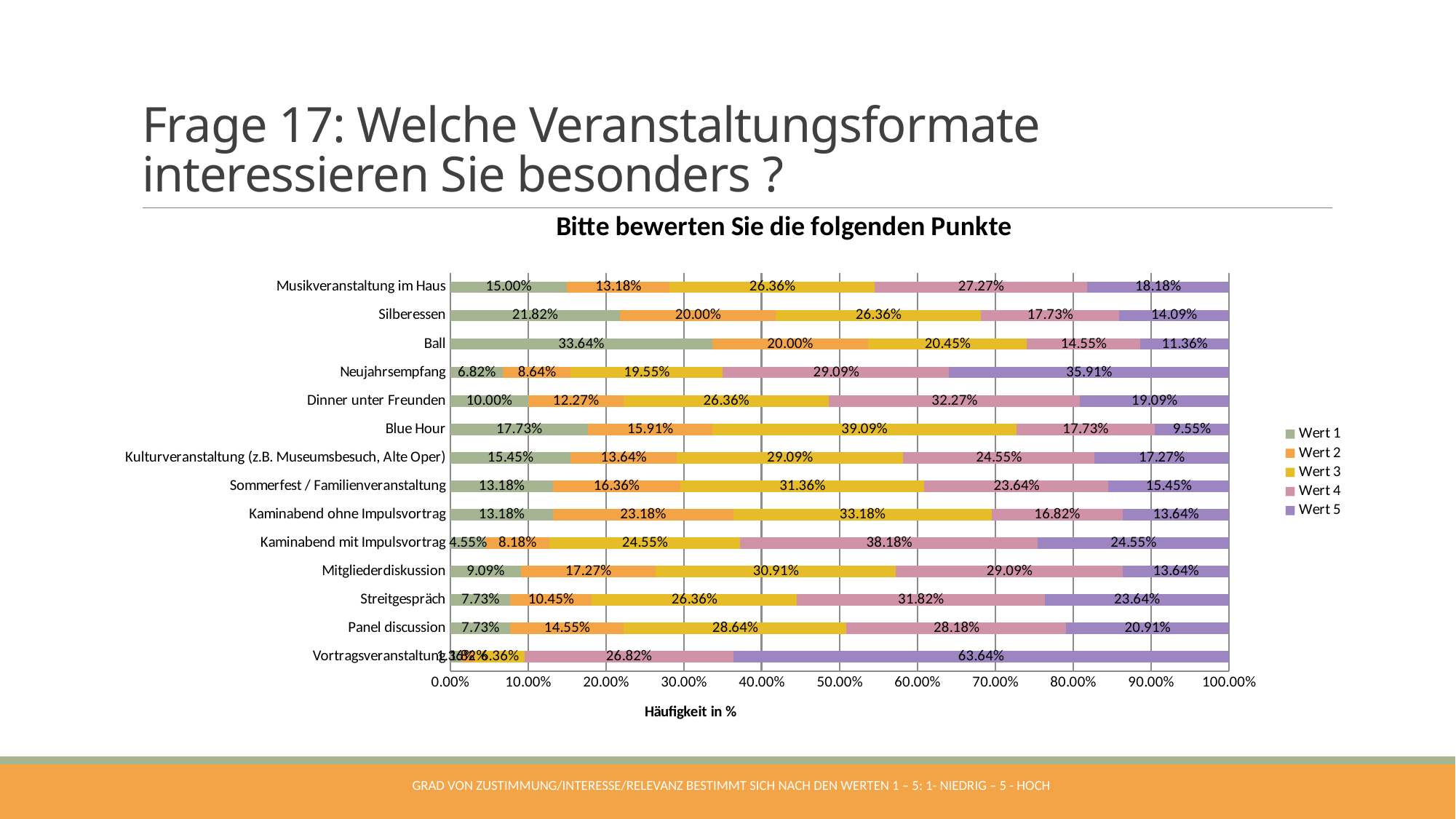
Which category has the lowest Wert 5 value? Blue Hour What is the difference between the Wert 5 value for Neujahrsempfang and the Wert 5 value for Ball? 24.55% How many series does the legend list? 5 Which has the larger Wert 4 value, Kaminabend mit Impulsvortrag or Dinner unter Freunden? Kaminabend mit Impulsvortrag What is the title of the horizontal axis? Häufigkeit in % How many categories are shown on the chart? 14 What is the Wert 5 value for Vortragsveranstaltung? 63.64% Which category has the highest Wert 5 value? Vortragsveranstaltung What is the Wert 3 value for Blue Hour? 39.09% What is the Wert 4 value for Kaminabend mit Impulsvortrag? 38.18% What is the Wert 1 value for Ball? 33.64% Which category has the highest Wert 1 value? Ball